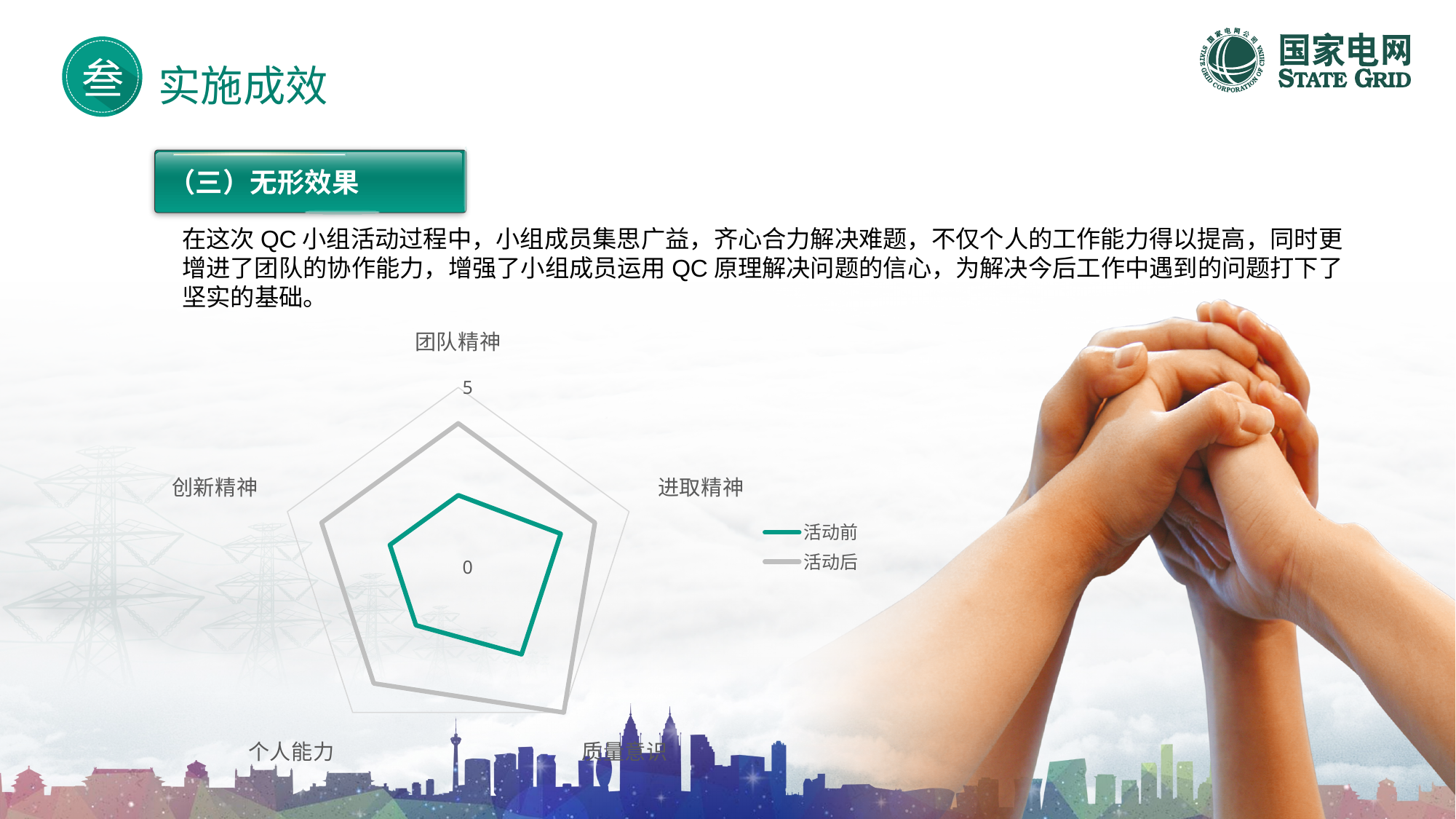
What kind of chart is shown on the slide? Radar chart How many series does the chart's legend list? 2 For 个人能力, which series has the larger value, 活动前 or 活动后? 活动后 How many categories (axes) does the radar chart have? 5 What is the maximum value shown on the radar chart's axis scale? 5 Which series is drawn in grey on the radar chart? 活动后 Which series is drawn in green on the radar chart? 活动前 Is the 活动前 value for 进取精神 greater or less than 5? less For 团队精神, which series has the larger value, 活动前 or 活动后? 活动后 For 创新精神, which series has the larger value, 活动前 or 活动后? 活动后